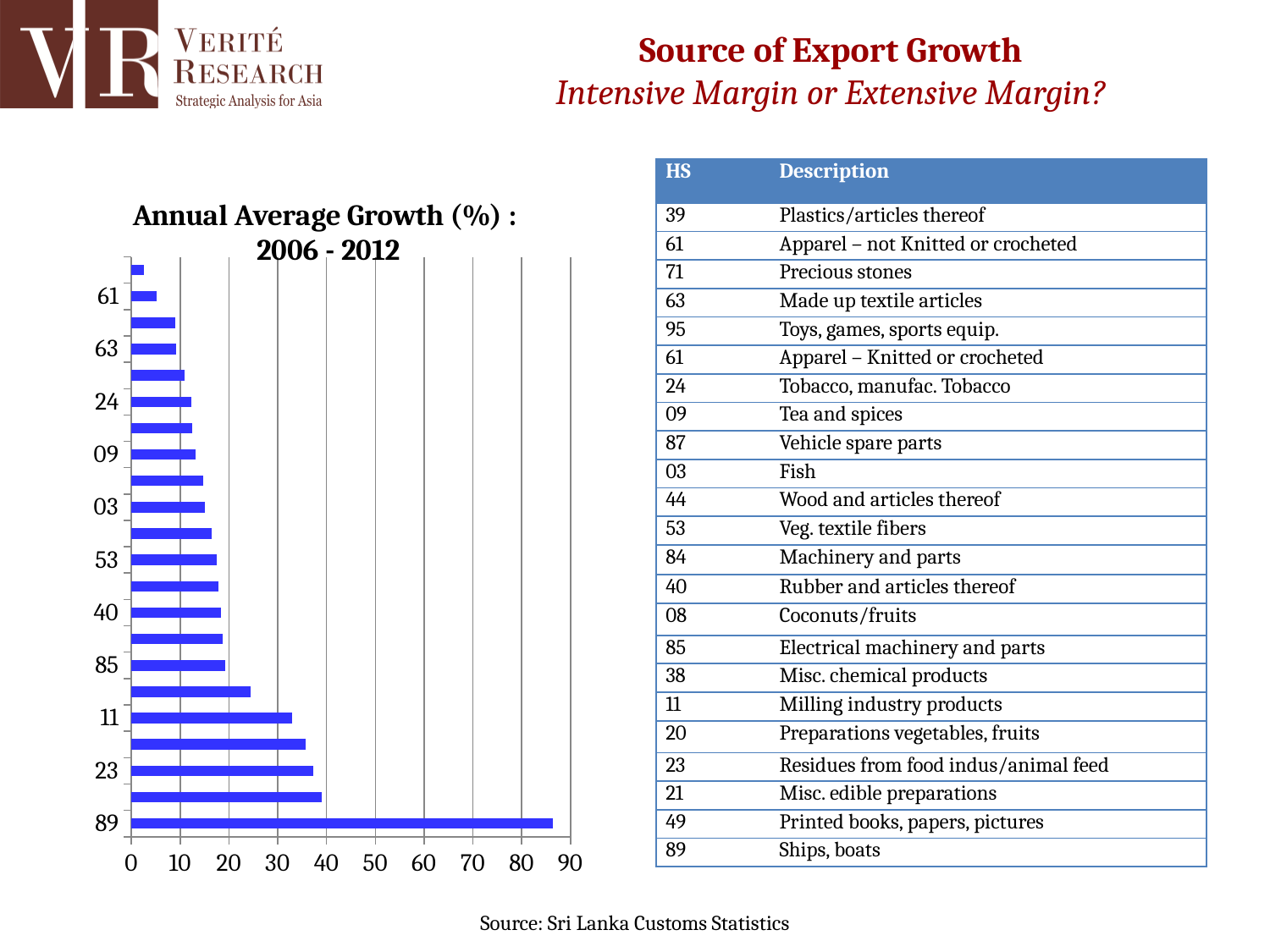
Is the value for HS 89 greater or less than 80? greater Do the bar values increase or decrease going from the top of the chart to the bottom? increase Which has the larger value, HS 11 or HS 85? 11 Which has the larger value, HS 89 or HS 23? 89 Is the value for HS 23 greater or less than 30? greater Is the value for HS 61 greater or less than 10? less What is the title of the chart? Annual Average Growth (%) : 2006 - 2012 Which HS code has the highest annual average growth in the chart? 89 What kind of chart is shown on the slide? bar chart How many bars are plotted in the chart? 22